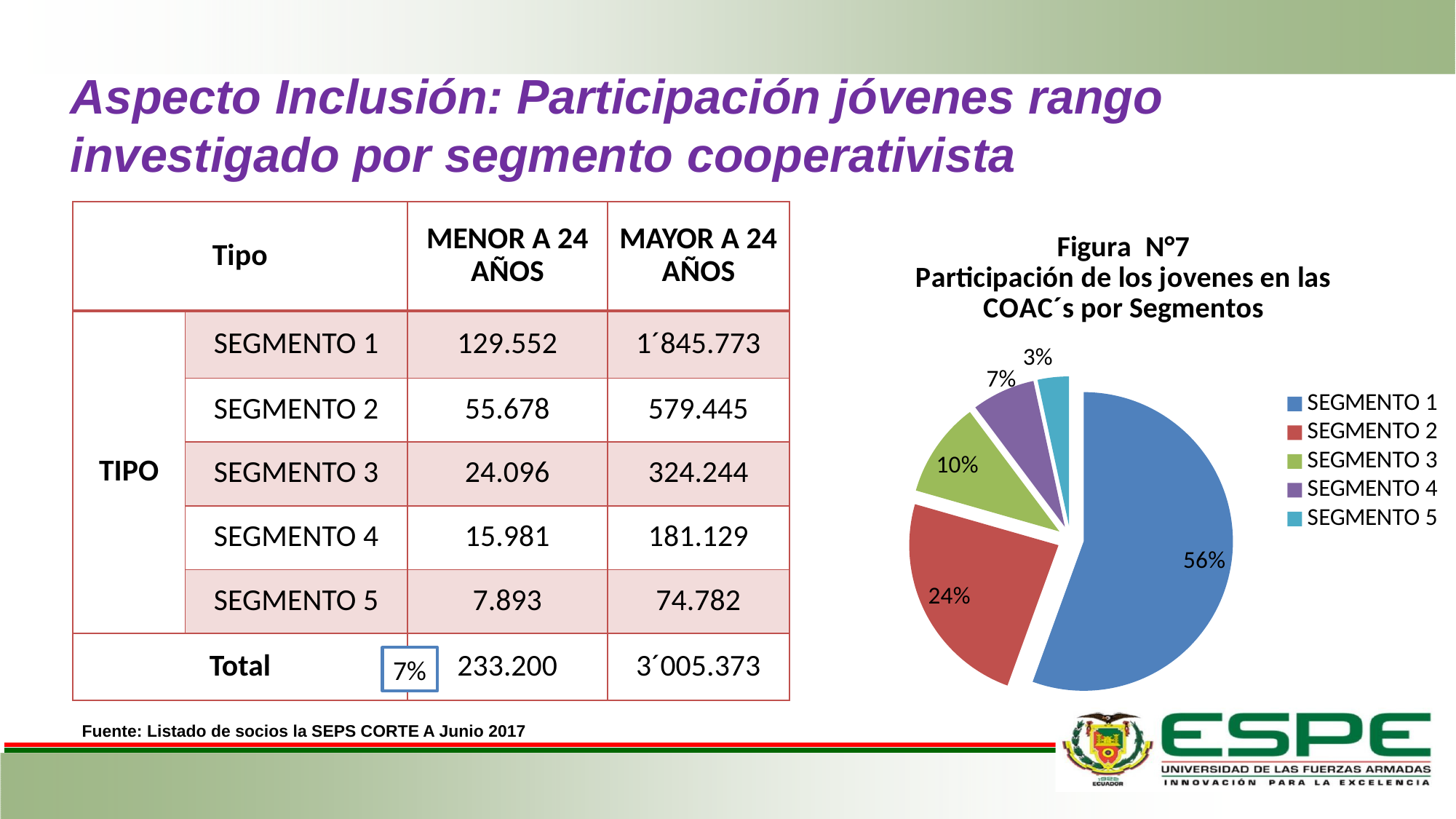
In the pie chart, what share does SEGMENTO 3 have? 10% What colour is the SEGMENTO 1 slice in the pie chart? blue In the pie chart, which is larger, the share of SEGMENTO 3 or SEGMENTO 4? SEGMENTO 3 Which segment has the smallest slice in the pie chart? SEGMENTO 5 In the pie chart, what share does SEGMENTO 2 have? 24% In the pie chart, how many percentage points larger is SEGMENTO 1's share than SEGMENTO 2's? 32 In the pie chart, what share does SEGMENTO 1 have? 56% Which segment has the largest slice in the pie chart? SEGMENTO 1 What kind of chart is Figura N°7? pie chart How many segments does the pie chart legend list? 5